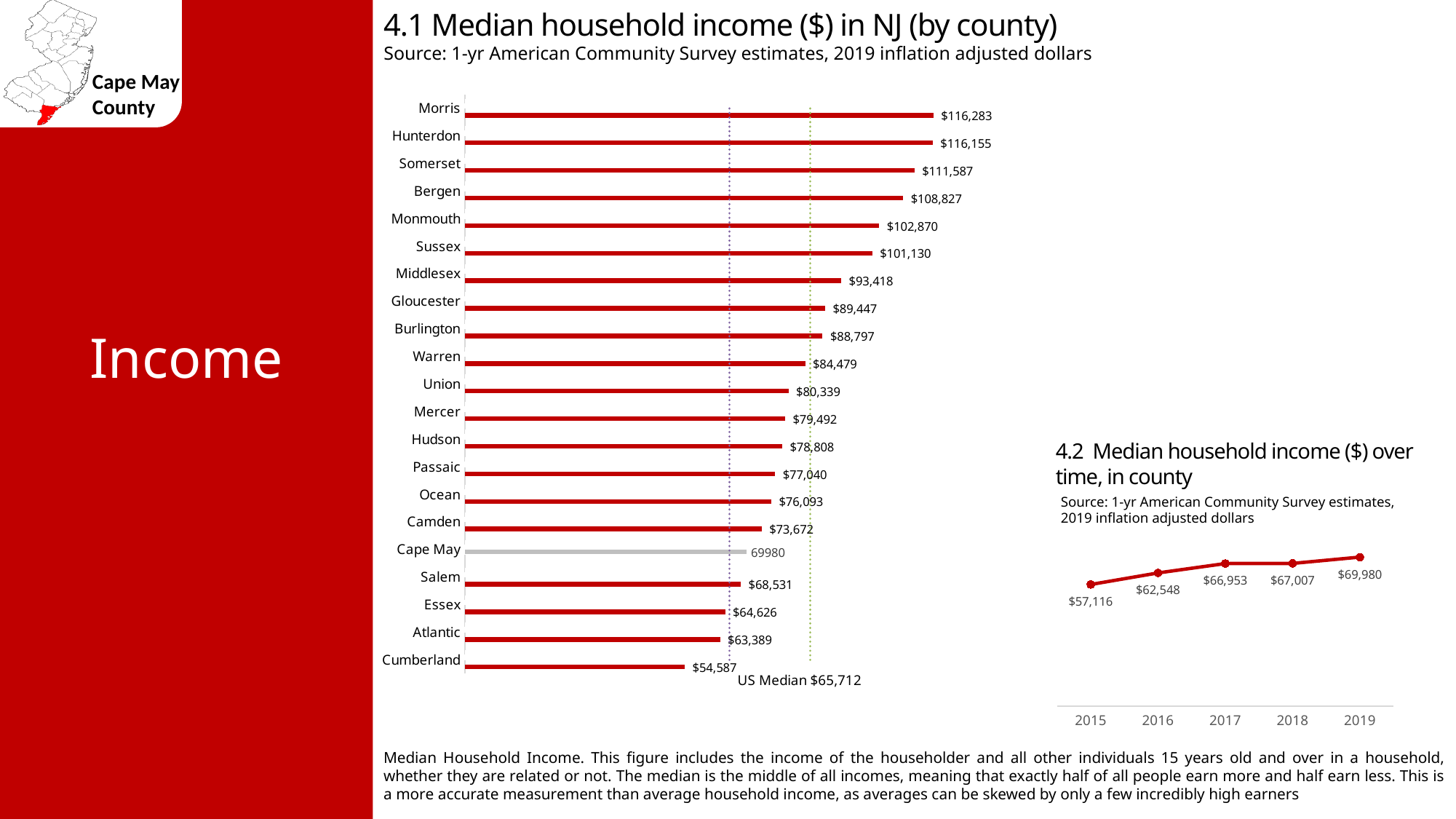
What type of chart is chart 4.1 (Median household income in NJ by county)? Bar chart In chart 4.1 (Median household income in NJ by county), which county has the lowest median household income? Cumberland In chart 4.1 (Median household income in NJ by county), what US Median value is labelled on the chart? $65,712 In chart 4.1 (Median household income in NJ by county), what is the median household income for Bergen? $108,827 In chart 4.1 (Median household income in NJ by county), what is the difference between the median household income of Morris and Cumberland? $61,696 In chart 4.2 (Median household income over time, in county), does the median household income rise or fall from 2015 to 2019? Rise In chart 4.1 (Median household income in NJ by county), how many counties are shown? 21 In chart 4.1 (Median household income in NJ by county), which has a higher median household income, Salem or Essex? Salem In chart 4.1 (Median household income in NJ by county), what is the median household income for Cape May? 69980 In chart 4.1 (Median household income in NJ by county), which county has the highest median household income? Morris In chart 4.2 (Median household income over time, in county), what is the difference between the 2019 and 2018 values? $2,973 In chart 4.2 (Median household income over time, in county), what was the median household income in 2015? $57,116